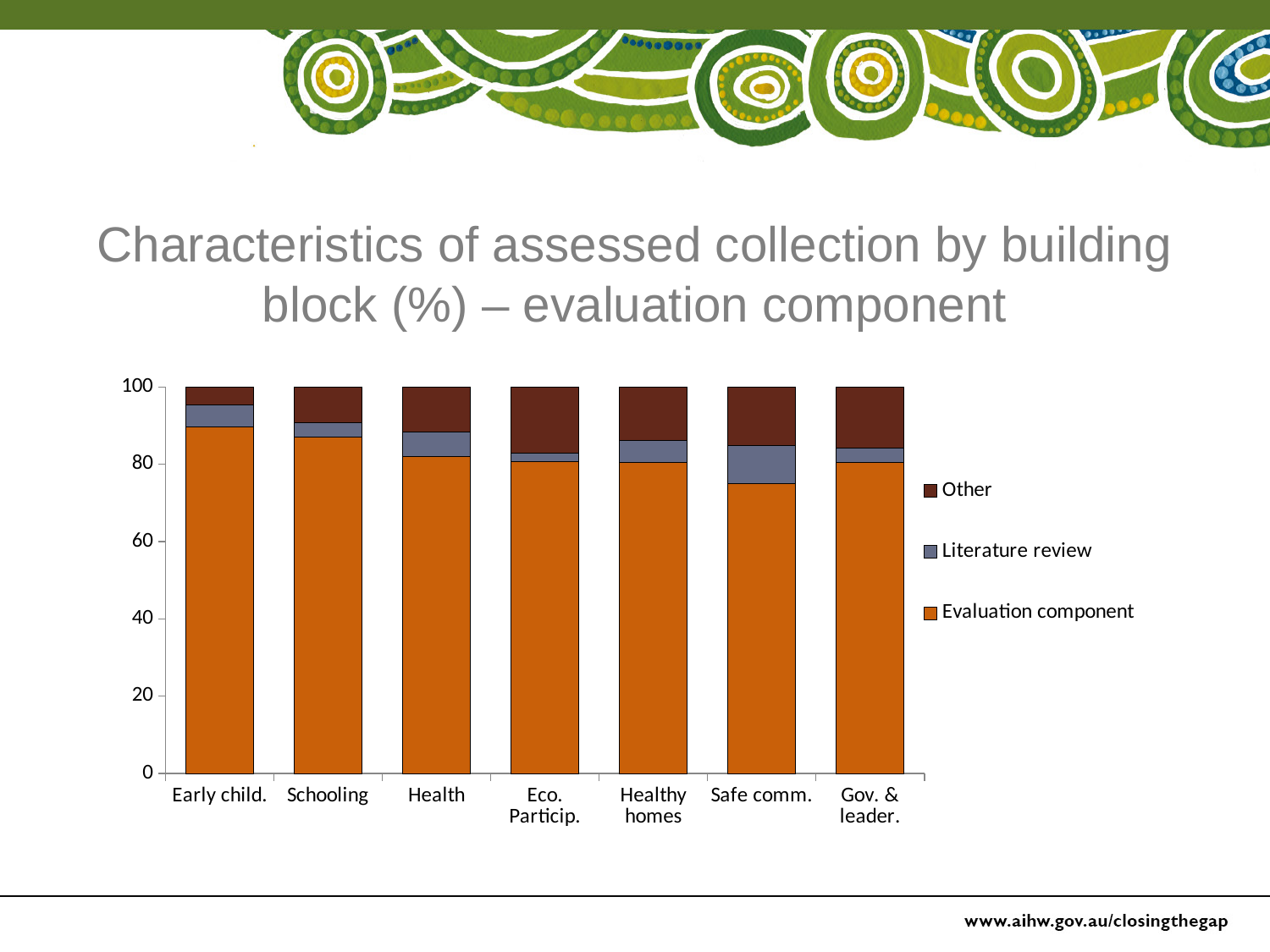
Which building block has the lowest value for Evaluation component? Safe comm. Which building block has the highest value for Evaluation component? Early child. How many building block categories are shown on the x axis? 7 Which series is shown in orange in the legend? Evaluation component What kind of chart is shown on the slide? Stacked bar chart Which is larger, the Evaluation component value for Schooling or for Safe comm.? Schooling What is the title of the chart on the slide? Characteristics of assessed collection by building block (%) – evaluation component Is the Evaluation component value for Early child. greater or less than 80? greater Which building block has the largest Other segment? Eco. Particip. How many series does the legend list? 3 Is the Evaluation component value for Safe comm. greater or less than 80? less What is the total height of the stacked bar for Health? 100